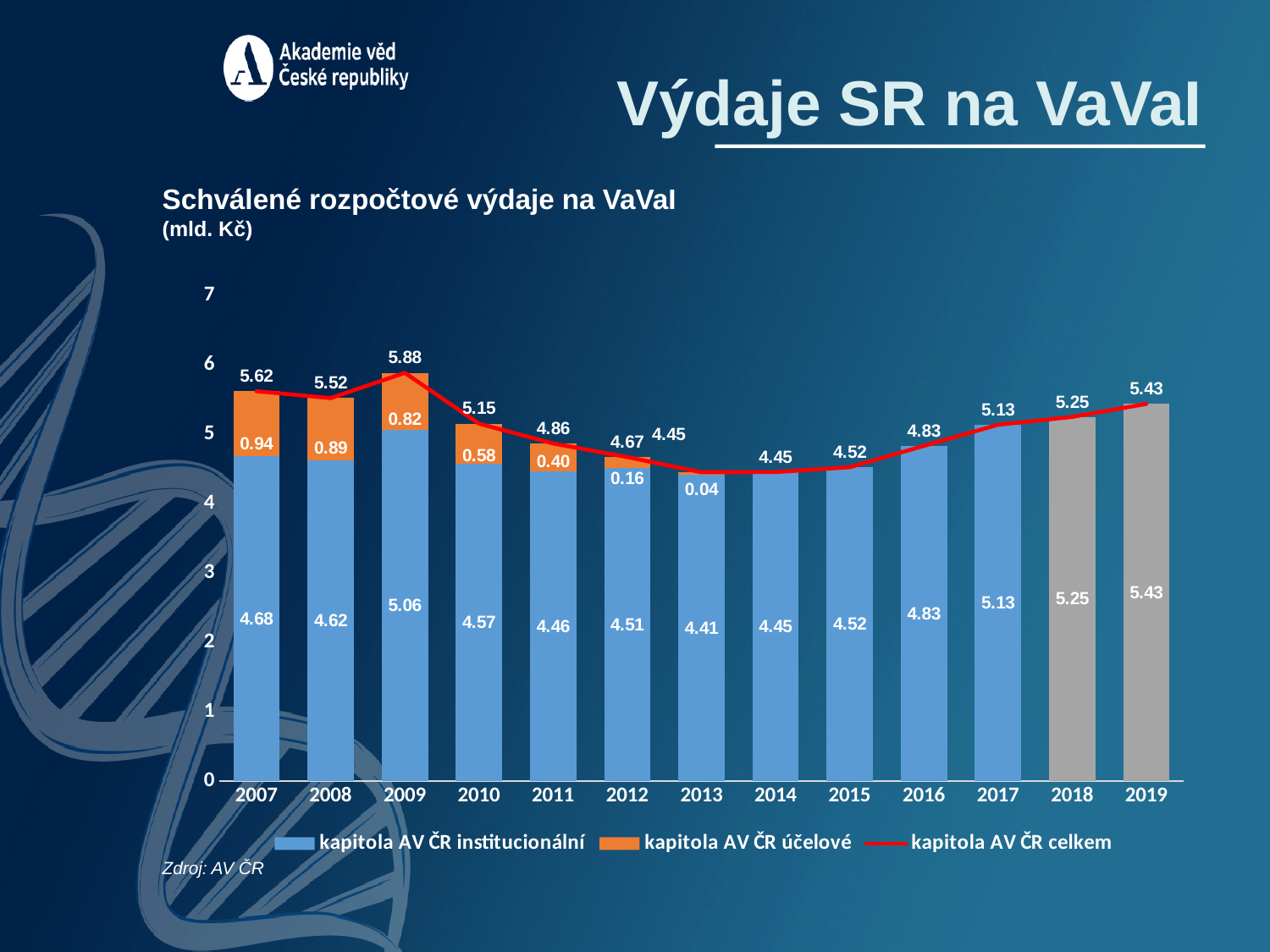
Which is larger, 'kapitola AV ČR institucionální' in 2016 or in 2017? 2017 What is the value of 'kapitola AV ČR institucionální' for 2009? 5.06 What kind of chart is this? Stacked bar chart with a line In which year is 'kapitola AV ČR celkem' highest? 2009 How many years are shown on the x axis? 13 What is the total of the stacked bar for 2012? 4.67 What is the value of 'kapitola AV ČR celkem' for 2011? 4.86 How many series does the legend list? 3 In which year is 'kapitola AV ČR institucionální' lowest? 2013 Does 'kapitola AV ČR účelové' rise or fall from 2007 to 2013? Fall What is the value of 'kapitola AV ČR účelové' for 2010? 0.58 What is the difference between 'kapitola AV ČR celkem' in 2009 and in 2010? 0.73